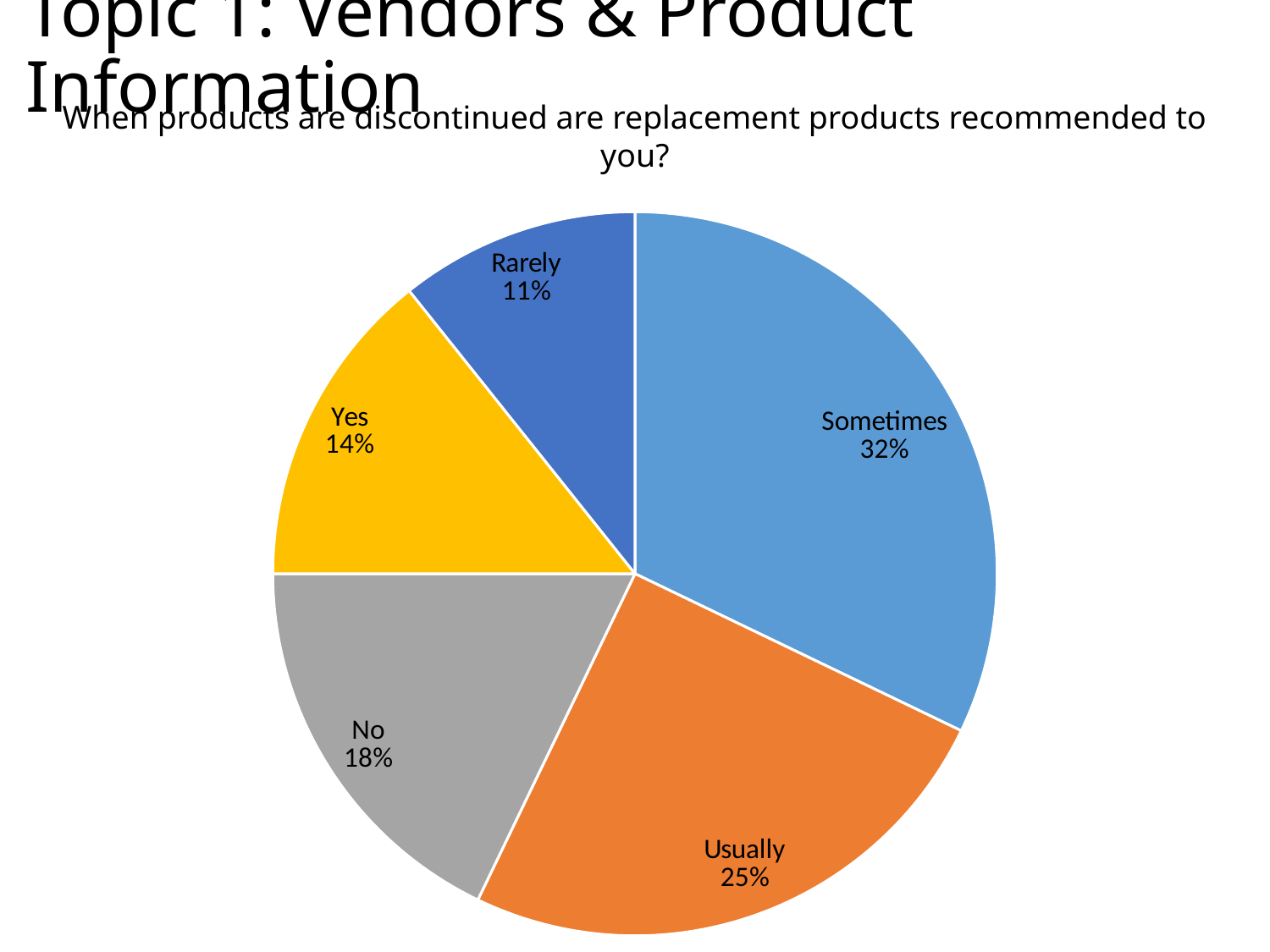
Which response has the smallest share of the pie? Rarely What is the title of the chart? When products are discontinued are replacement products recommended to you? What percentage of respondents answered "Sometimes"? 32% How many response categories are shown in the pie chart? 5 What percentage of respondents answered "Yes"? 14% What percentage of respondents answered "No"? 18% What percentage of respondents answered "Usually"? 25% What type of chart is shown on the slide? pie chart What percentage of respondents answered "Rarely"? 11% Which is larger, the share for "No" or the share for "Yes"? No What is the difference in percentage points between "Sometimes" and "Usually"? 7 Which response has the largest share of the pie? Sometimes